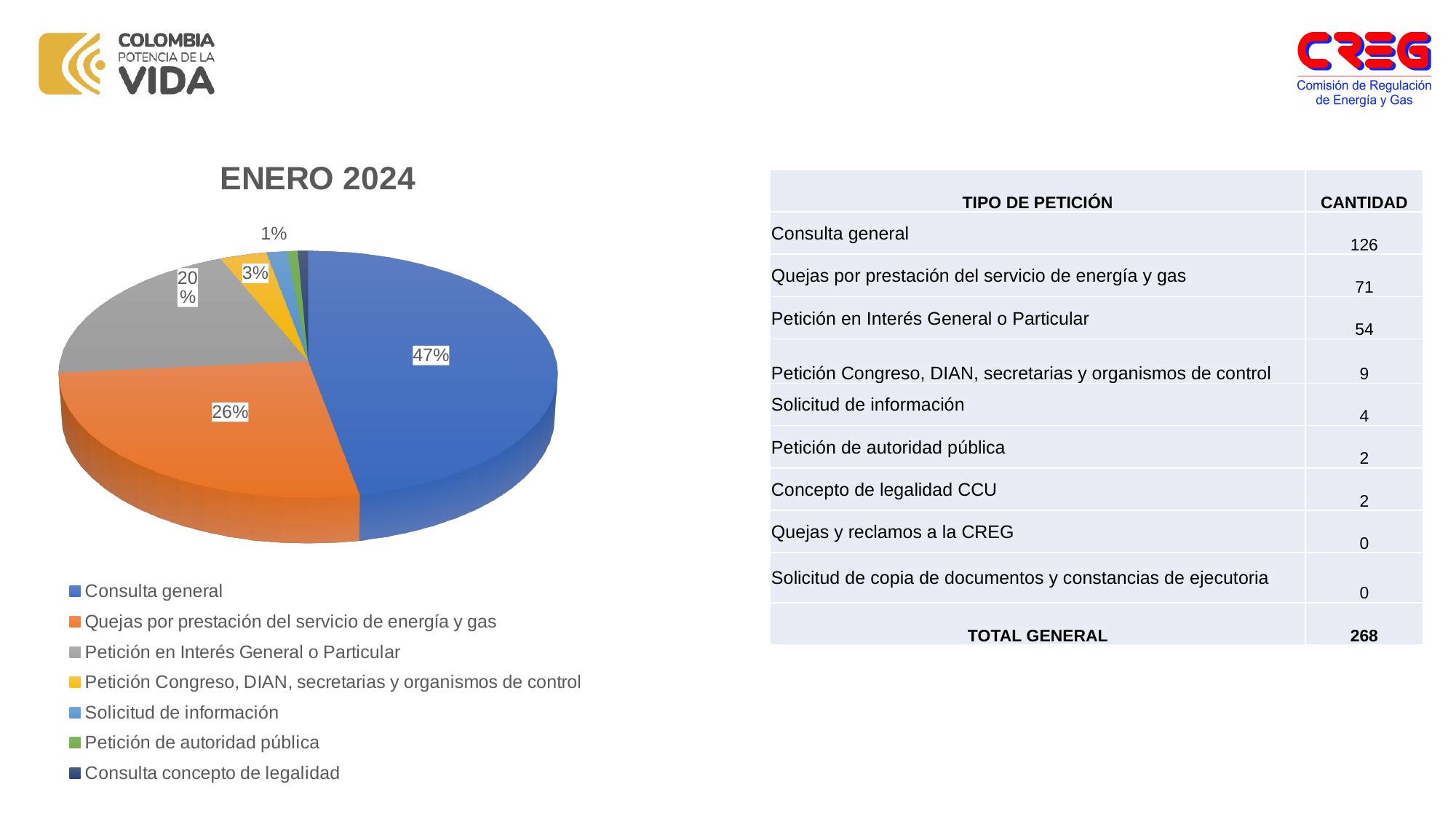
What share of the pie does Quejas por prestación del servicio de energía y gas represent? 26% Which category has the largest slice of the pie? Consulta general How many entries does the legend of the pie chart list? 7 What share of the pie does Consulta general represent? 47% Is the share for Petición en Interés General o Particular greater or less than 25%? less What is the title of the pie chart? ENERO 2024 What is the difference in percentage points between the Consulta general slice and the Quejas por prestación del servicio de energía y gas slice? 21 percentage points What share of the pie does Petición en Interés General o Particular represent? 20% Which colour is used for the Consulta general slice in the pie chart? Blue What kind of chart is shown under the title ENERO 2024? Pie chart Which is larger in the pie chart: Quejas por prestación del servicio de energía y gas or Petición en Interés General o Particular? Quejas por prestación del servicio de energía y gas